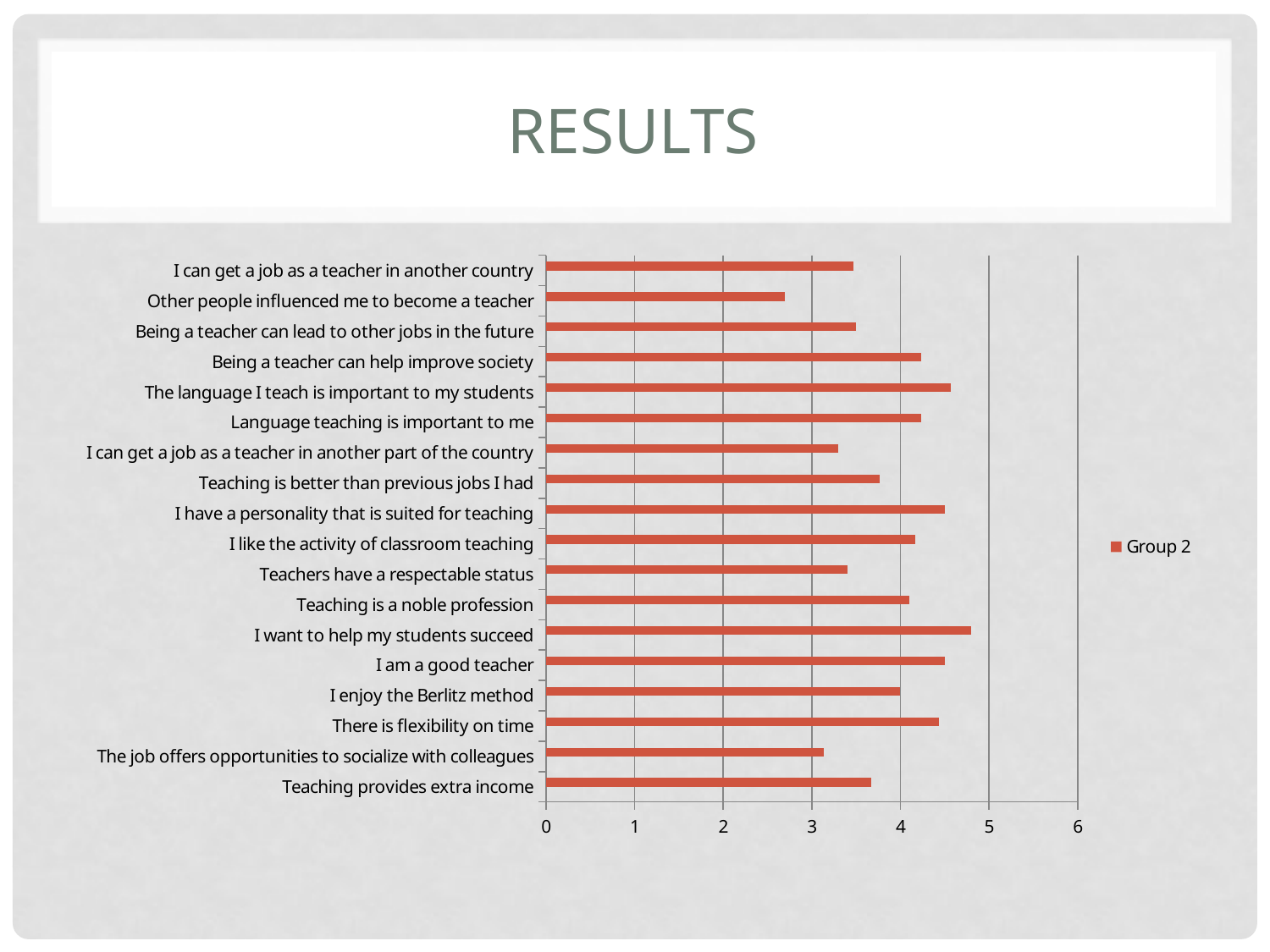
Which has the larger value: "The language I teach is important to my students" or "The job offers opportunities to socialize with colleagues"? The language I teach is important to my students What is the name of the series shown in the legend? Group 2 Is the value for "Being a teacher can help improve society" greater or less than 4? greater Which statement has the lowest value in the chart? Other people influenced me to become a teacher How many categories (statements) are plotted in the chart? 18 Which has the larger value: "I want to help my students succeed" or "Other people influenced me to become a teacher"? I want to help my students succeed Is the value for "Other people influenced me to become a teacher" greater or less than 3? less Is the value for "I want to help my students succeed" greater or less than 4? greater What kind of chart is shown on the slide? Bar chart Which statement has the highest value in the chart? I want to help my students succeed How many series does the legend list? 1